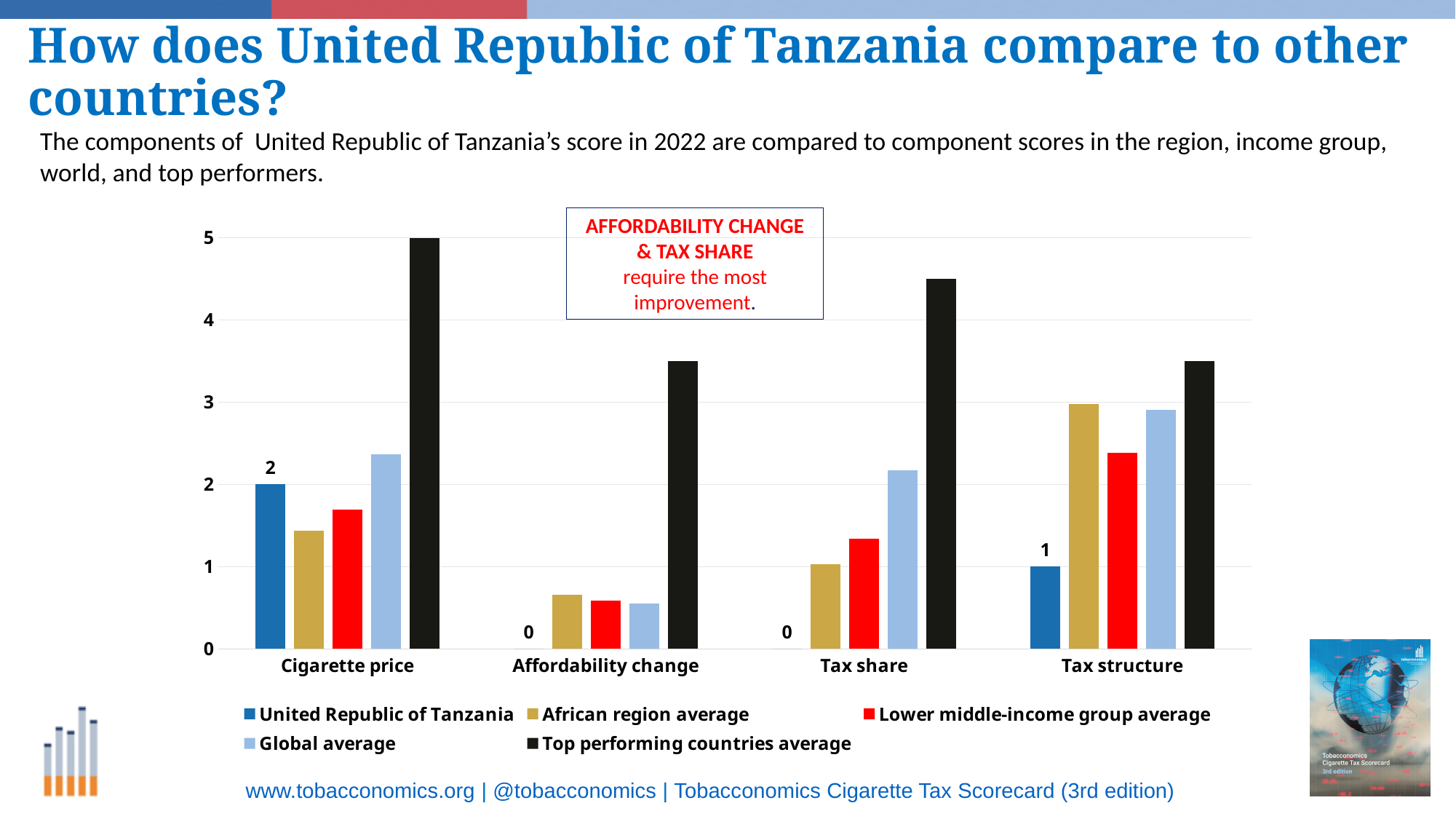
What is the difference between United Republic of Tanzania's Cigarette price value and its Tax structure value? 1 What is the value for Top performing countries average in the Cigarette price category? 5 How many series does the legend list? 5 What is the value for United Republic of Tanzania in the Tax structure category? 1 In which category does United Republic of Tanzania have its highest value? Cigarette price What kind of chart is shown on the slide? Bar chart In the Tax structure category, which is larger: United Republic of Tanzania or African region average? African region average How many categories are shown on the x axis of the chart? 4 What is the value for United Republic of Tanzania in the Cigarette price category? 2 Is the value for African region average in the Affordability change category greater or less than 1? less Is the value for Top performing countries average in the Tax share category greater or less than 4? greater What is the value for United Republic of Tanzania in the Affordability change category? 0